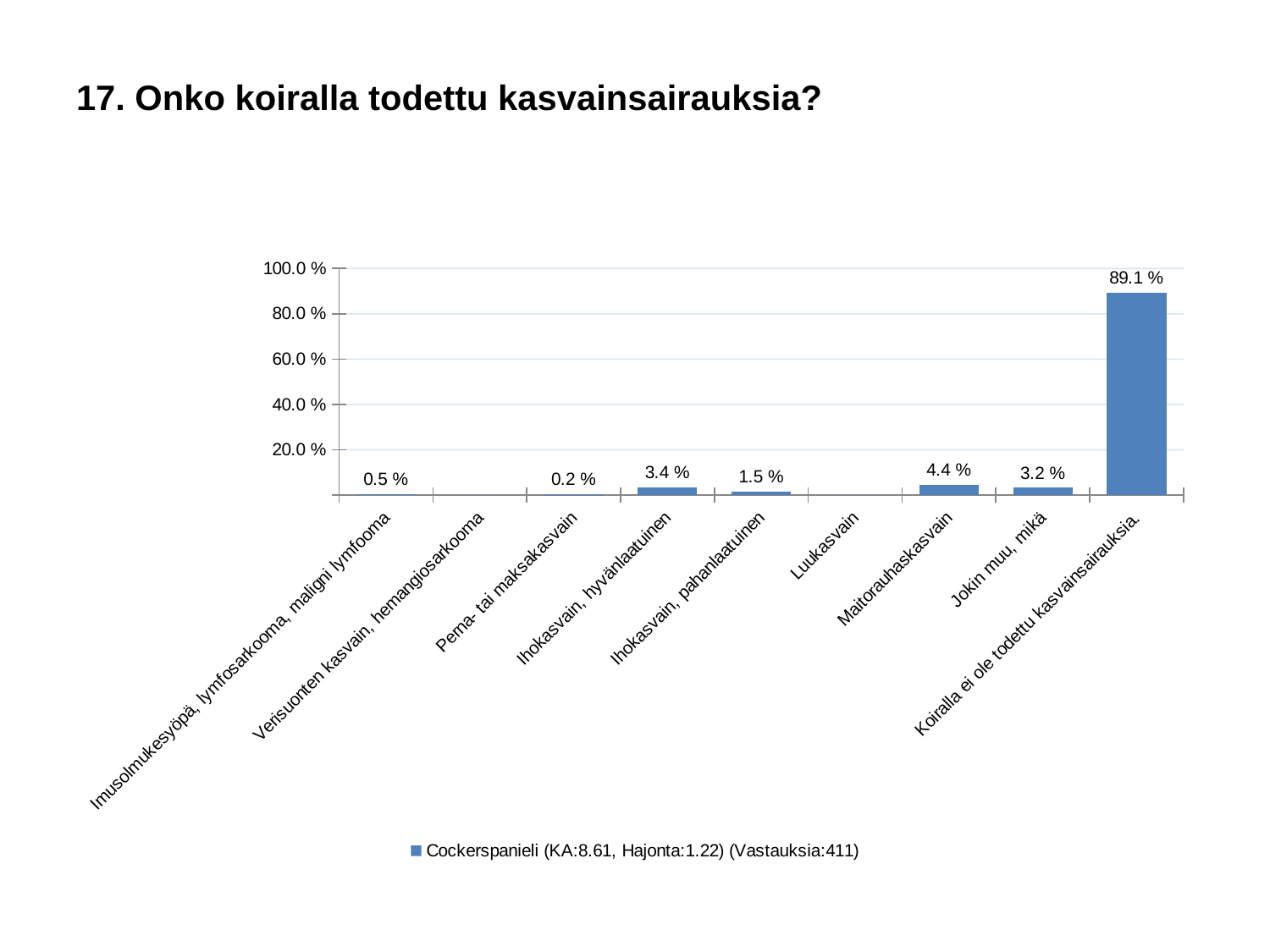
How many series does the legend list? 1 What kind of chart is shown on the slide? bar chart What is the value for "Maitorauhaskasvain"? 4.4 % What is the value for "Jokin muu, mikä"? 3.2 % What is the value for "Ihokasvain, hyvänlaatuinen"? 3.4 % What is the value for "Perna- tai maksakasvain"? 0.2 % Is the value for "Koiralla ei ole todettu kasvainsairauksia." greater or less than 80.0 %? greater What is the value for "Koiralla ei ole todettu kasvainsairauksia."? 89.1 % What is the difference between the values for "Maitorauhaskasvain" and "Ihokasvain, pahanlaatuinen"? 2.9 % Which category has the highest value? Koiralla ei ole todettu kasvainsairauksia. How many categories are shown on the x axis? 9 Which is larger, the value for "Ihokasvain, hyvänlaatuinen" or the value for "Jokin muu, mikä"? Ihokasvain, hyvänlaatuinen